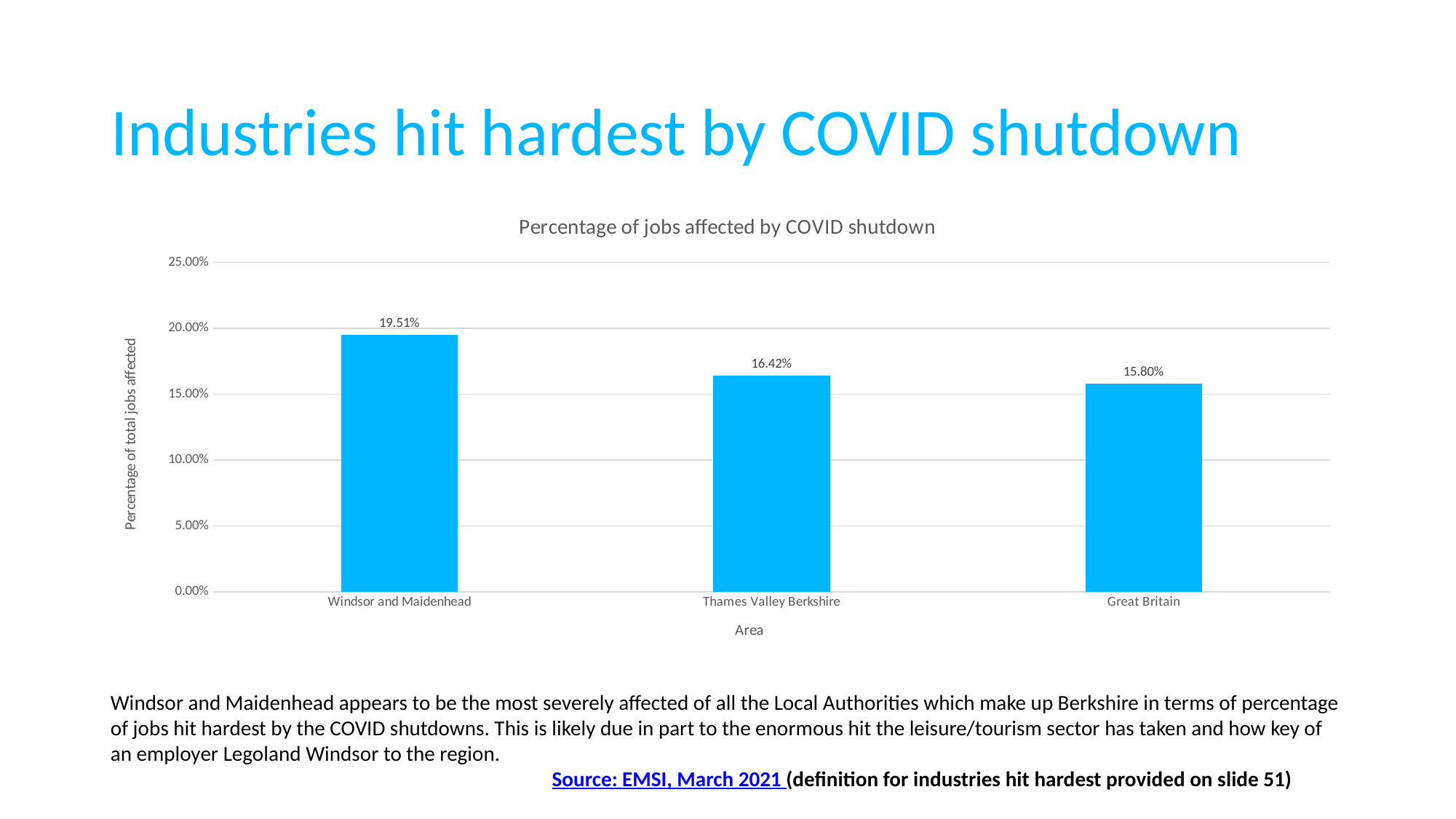
What is the percentage of jobs affected by COVID shutdown for Great Britain? 15.80% What is the title of the chart? Percentage of jobs affected by COVID shutdown What is the percentage of jobs affected by COVID shutdown for Windsor and Maidenhead? 19.51% Which area has the highest percentage of jobs affected by COVID shutdown? Windsor and Maidenhead Which has a higher percentage of jobs affected: Windsor and Maidenhead or Thames Valley Berkshire? Windsor and Maidenhead What kind of chart is shown on the slide? Bar chart What is the difference in percentage points between Thames Valley Berkshire and Great Britain? 0.62% What is the difference in percentage points between Windsor and Maidenhead and Great Britain? 3.71% How many areas are shown in the chart? 3 What is the percentage of jobs affected by COVID shutdown for Thames Valley Berkshire? 16.42% Is the value for Thames Valley Berkshire greater or less than 15.00%? greater Which area has the lowest percentage of jobs affected by COVID shutdown? Great Britain